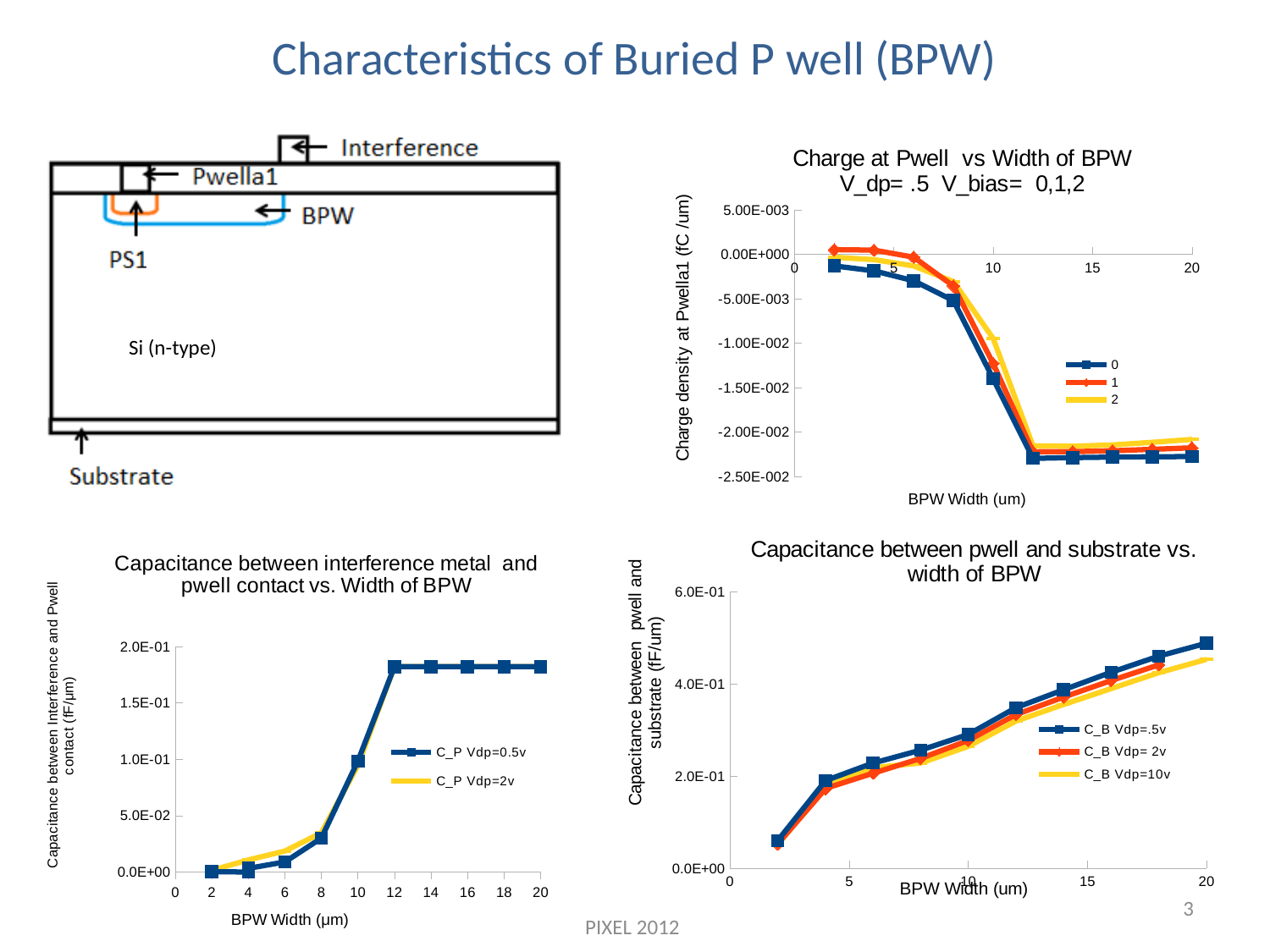
How many series does the legend of the 'Capacitance between pwell and substrate vs. width of BPW' chart list? 3 In the 'Charge at Pwell vs Width of BPW' chart, do the values rise or fall as BPW width increases? fall In the 'Capacitance between interference metal and pwell contact vs. Width of BPW' chart, is the value for C_P Vdp=0.5v at BPW width 8 greater or less than 5.0E-02? less What kind of chart is the 'Charge at Pwell vs Width of BPW' chart? line chart In the 'Capacitance between pwell and substrate vs. width of BPW' chart, is the value for C_B Vdp=.5v at BPW width 20 greater or less than 4.0E-01? greater In the 'Capacitance between pwell and substrate vs. width of BPW' chart, do the values rise or fall as BPW width increases? rise In the 'Capacitance between pwell and substrate vs. width of BPW' chart, is the value for C_B Vdp=.5v at BPW width 2 greater or less than 2.0E-01? less How many series does the legend of the 'Charge at Pwell vs Width of BPW' chart list? 3 How many series does the legend of the 'Capacitance between interference metal and pwell contact vs. Width of BPW' chart list? 2 What is the x-axis label of the 'Charge at Pwell vs Width of BPW' chart? BPW Width (um)